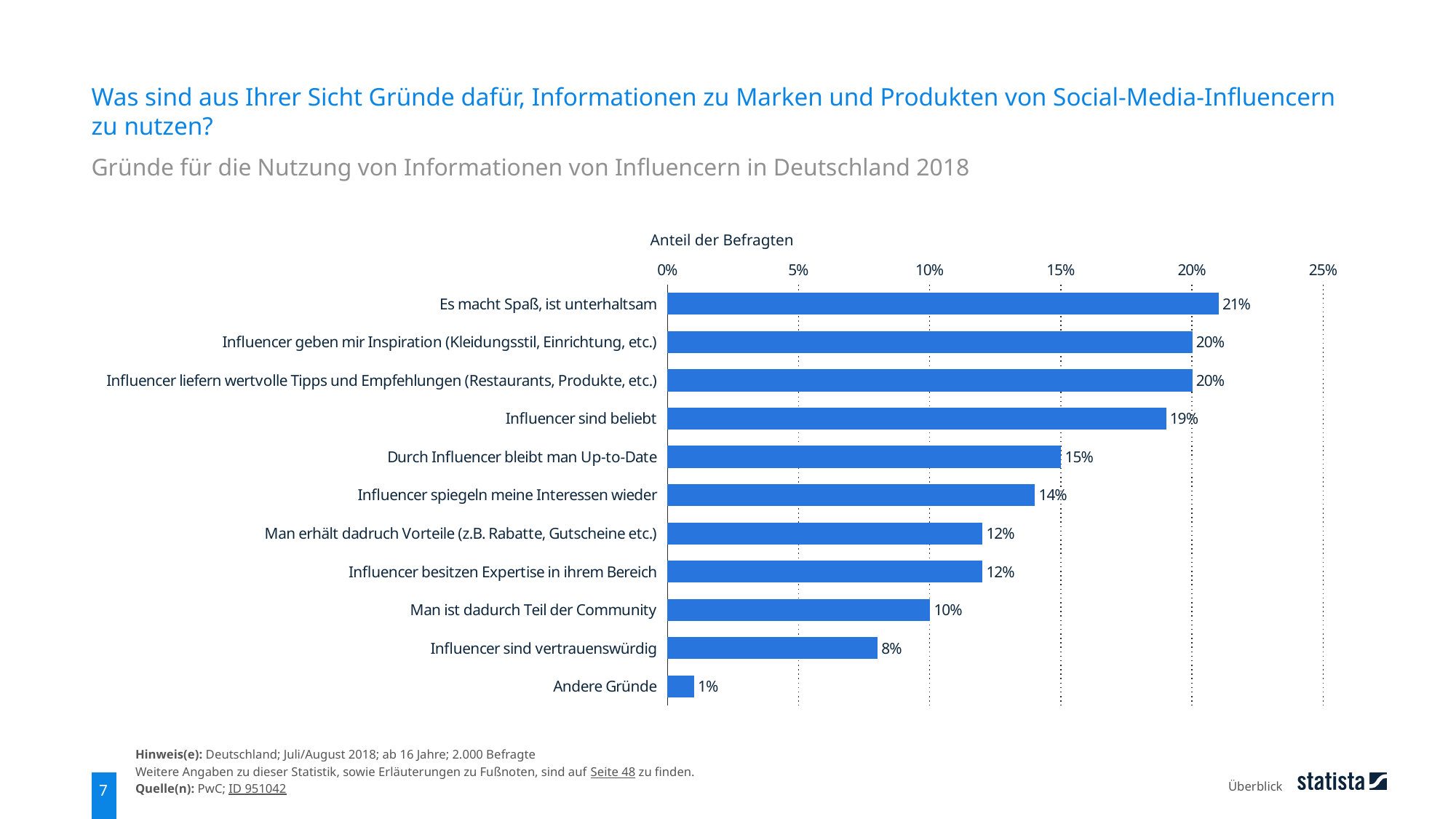
What is the label of the value axis? Anteil der Befragten How many categories are shown in the chart? 11 What is the value for "Influencer sind beliebt"? 19% What kind of chart is shown on the slide? Bar chart What is the value for "Influencer sind vertrauenswürdig"? 8% What is the value for "Es macht Spaß, ist unterhaltsam"? 21% Is the value for "Influencer sind beliebt" greater or less than 15%? greater Which category has the lowest value? Andere Gründe What is the difference between "Es macht Spaß, ist unterhaltsam" and "Man ist dadurch Teil der Community"? 11% Which is larger: "Durch Influencer bleibt man Up-to-Date" or "Influencer spiegeln meine Interessen wieder"? Durch Influencer bleibt man Up-to-Date Which category has the highest value? Es macht Spaß, ist unterhaltsam What is the difference between "Influencer geben mir Inspiration (Kleidungsstil, Einrichtung, etc.)" and "Influencer sind vertrauenswürdig"? 12%